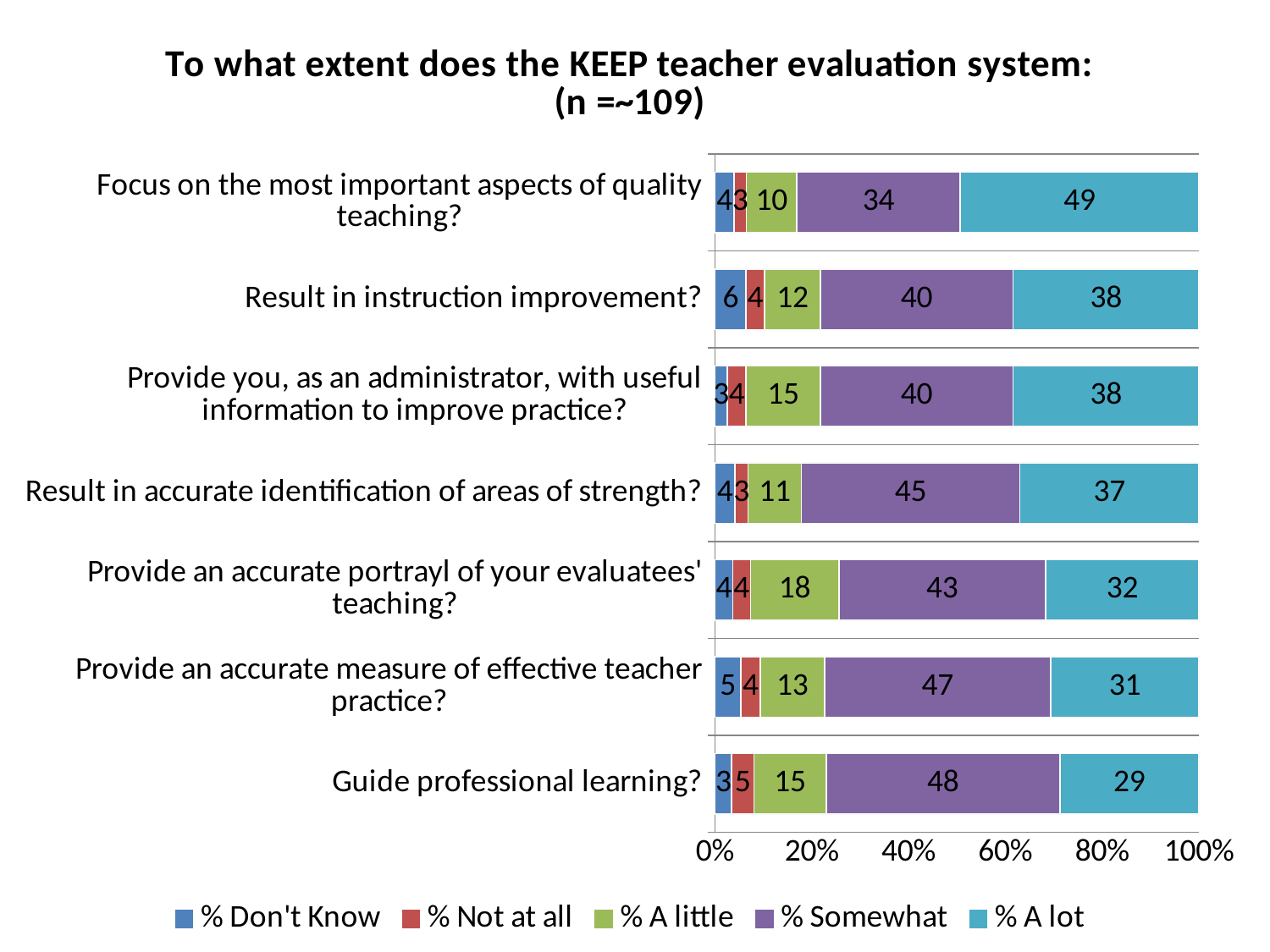
Which is larger: the % A lot value for "Result in instruction improvement?" or for "Provide an accurate measure of effective teacher practice?" Result in instruction improvement? What is the total of the stacked bar for "Result in instruction improvement?" 100 What is the sample size shown in the chart title? n =~109 What is the % A little value for "Provide an accurate portrayl of your evaluatees' teaching?" 18 How many series does the legend list? 5 How many question categories are plotted on the chart? 7 What is the % A lot value for "Focus on the most important aspects of quality teaching?" 49 Which category has the lowest % A lot value? Guide professional learning? Which category has the highest % A lot value? Focus on the most important aspects of quality teaching? What is the % Somewhat value for "Guide professional learning?" 48 What kind of chart is shown on the slide? Stacked bar chart What is the difference between the % Somewhat values for "Guide professional learning?" and "Focus on the most important aspects of quality teaching?" 14